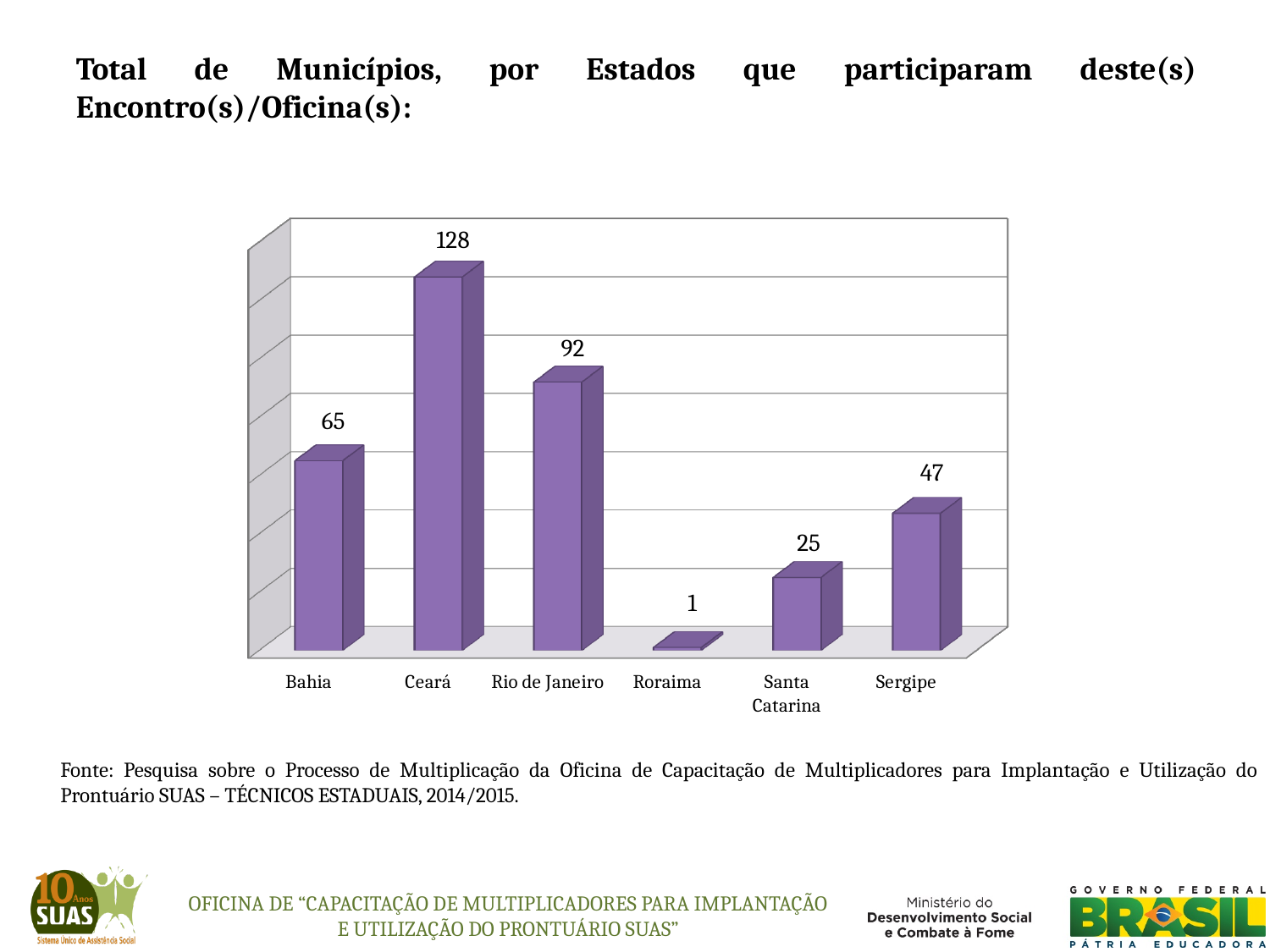
What is the value for Roraima? 1 How many states are shown on the chart? 6 What is the value for Ceará? 128 What is the value for Santa Catarina? 25 What is the difference between the values for Sergipe and Santa Catarina? 22 What is the value for Rio de Janeiro? 92 Which is larger, the value for Bahia or the value for Sergipe? Bahia What colour are the bars in the chart? Purple Which state has the highest value? Ceará What kind of chart is shown on the slide? Bar chart Which state has the lowest value? Roraima What is the difference between the values for Ceará and Bahia? 63